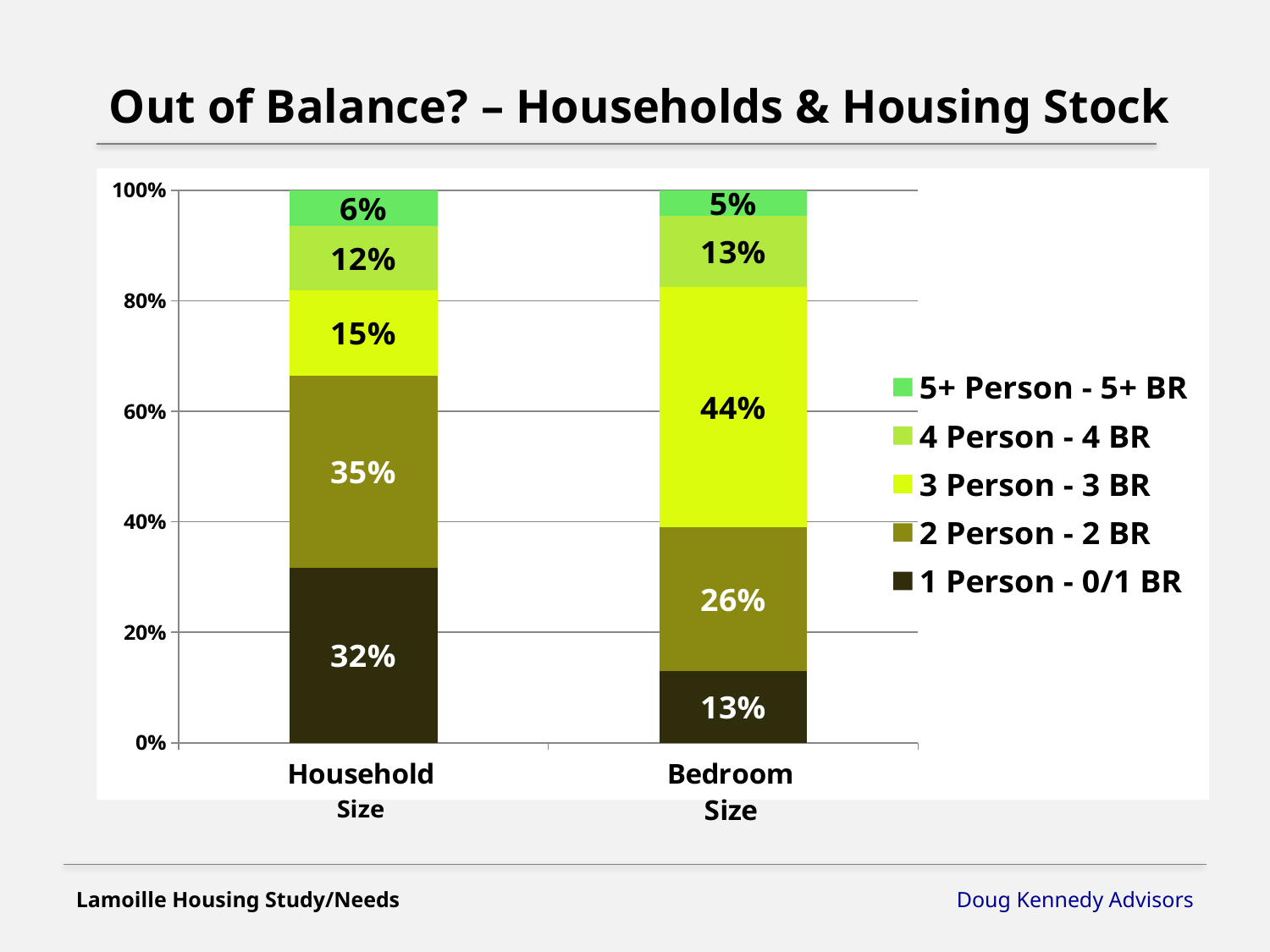
Which series has the largest share in the Bedroom Size bar? 3 Person - 3 BR Which series has the smallest share in the Household Size bar? 5+ Person - 5+ BR What is the difference between the 1 Person - 0/1 BR values for Household Size and Bedroom Size? 19 percentage points What is the title of the slide? Out of Balance? – Households & Housing Stock What kind of chart is shown on the slide? Stacked bar chart What is the value for 1 Person - 0/1 BR in the Household Size bar? 32% How many categories are shown on the x axis? 2 What is the value for 2 Person - 2 BR in the Bedroom Size bar? 26% What is the value for 3 Person - 3 BR in the Bedroom Size bar? 44% How many series does the legend list? 5 Which is larger: the 2 Person - 2 BR value for Household Size or for Bedroom Size? Household Size What is the value for 5+ Person - 5+ BR in the Household Size bar? 6%